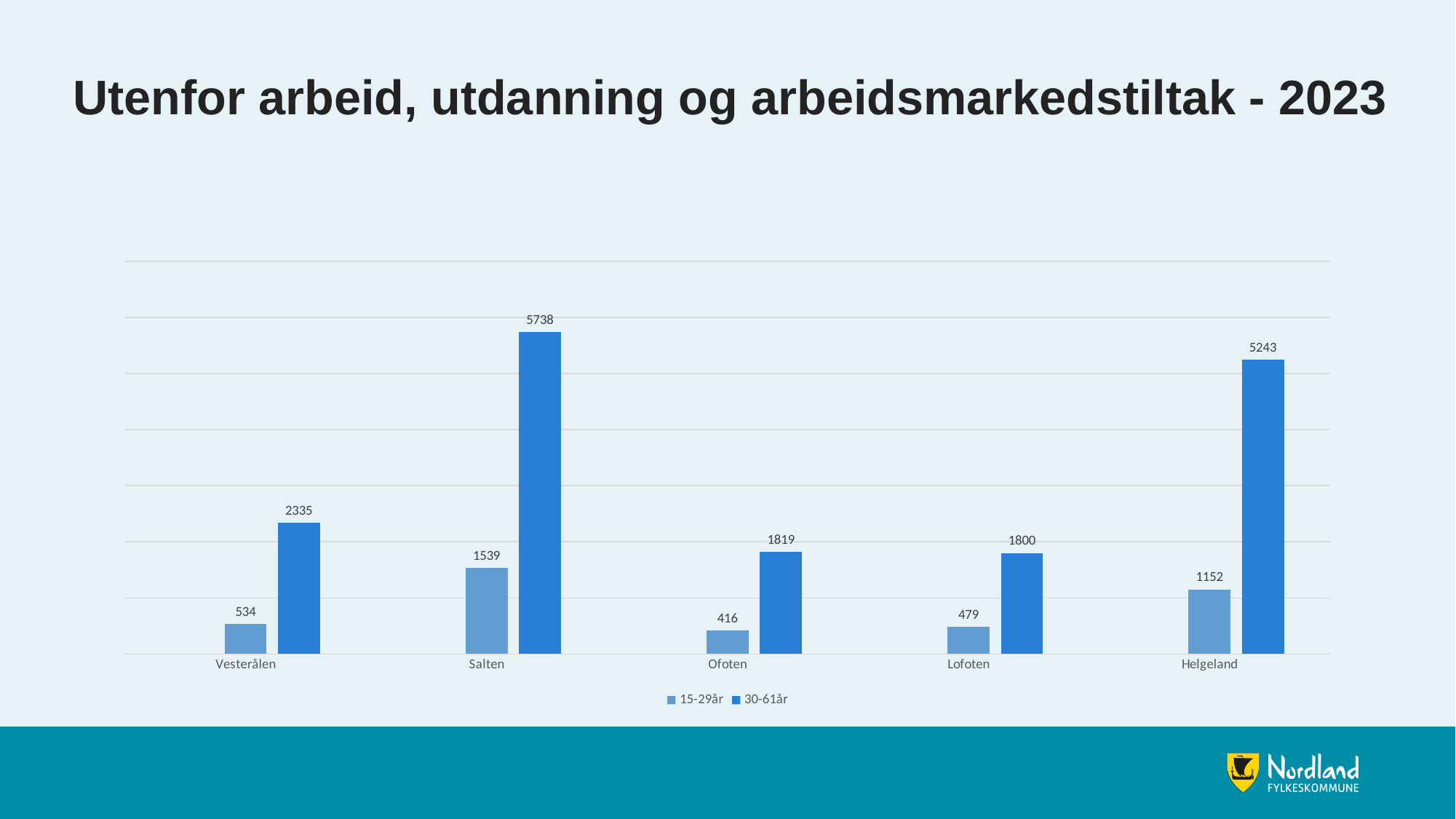
Which is larger: the 30-61år value for Ofoten or for Lofoten? Ofoten How many regions are shown on the x axis? 5 What is the value for the 30-61år series in Salten? 5738 What is the difference between the 30-61år values for Salten and Helgeland? 495 What is the title of the slide? Utenfor arbeid, utdanning og arbeidsmarkedstiltak - 2023 Which region has the highest value for the 30-61år series? Salten Which region has the lowest value for the 15-29år series? Ofoten What is the value for the 15-29år series in Helgeland? 1152 What is the value for the 15-29år series in Ofoten? 416 How many series does the legend list? 2 What is the total of the 15-29år and 30-61år values for Vesterålen? 2869 What kind of chart is shown on the slide? Bar chart